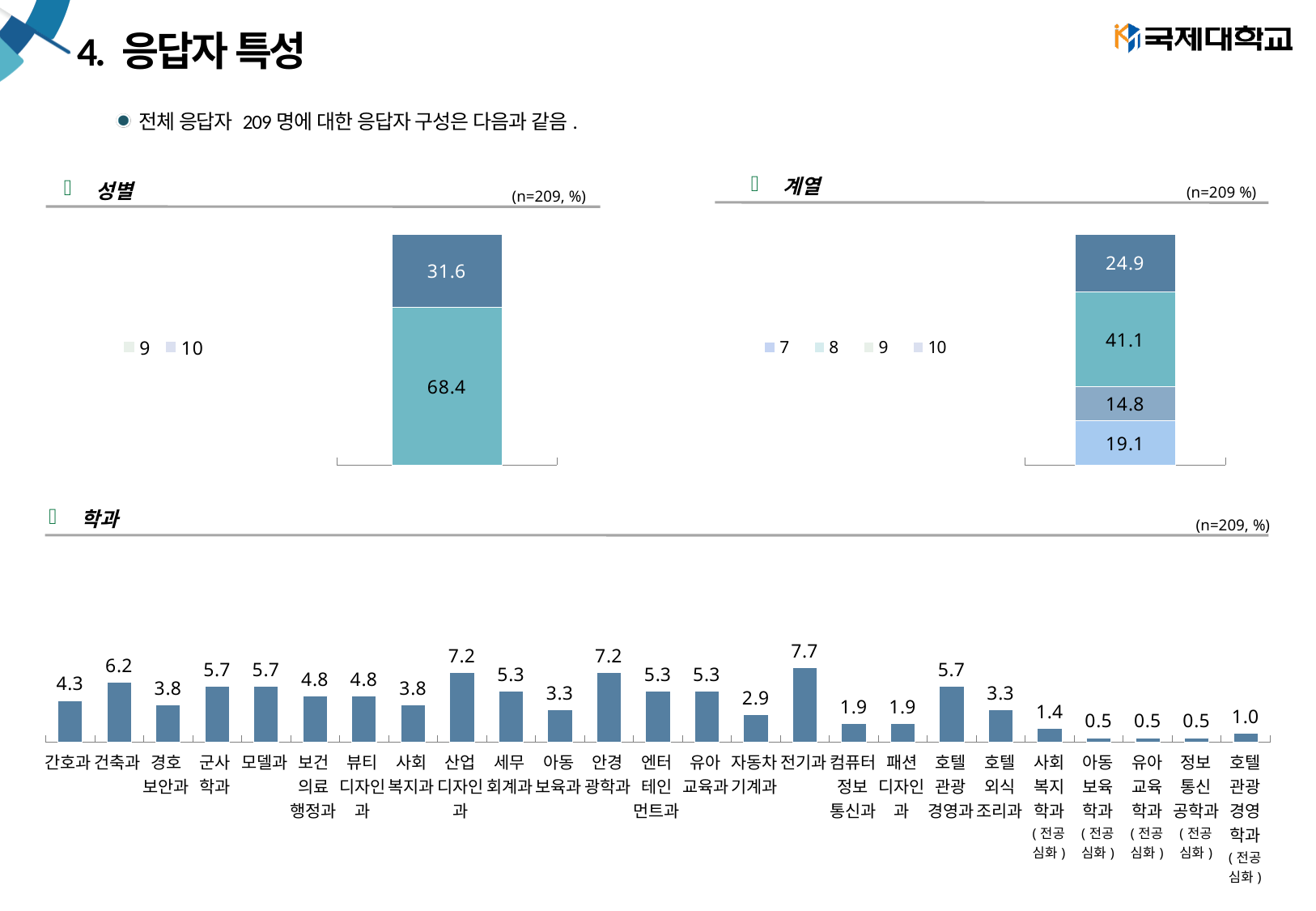
In the 학과 chart, which department has the highest value? 전기과 What kind of chart is the 학과 chart? bar chart In the 학과 chart, what is the value for 산업디자인과? 7.2 How many series does the legend of the 계열 chart list? 4 In the 계열 chart, what is the value of the largest segment of the stacked bar? 41.1 In the 계열 chart, what is the total of all segments in the stacked bar? 99.9 In the 학과 chart, what is the value for 자동차기계과? 2.9 In the 학과 chart, what is the difference between the values for 전기과 and 간호과? 3.4 In the 성별 chart, what is the value of the top segment of the stacked bar? 31.6 In the 학과 chart, which is larger, the value for 건축과 or the value for 경호보안과? 건축과 In the 계열 chart, what is the value of the bottom segment of the stacked bar? 19.1 In the 성별 chart, what is the value of the larger (lower) segment of the stacked bar? 68.4